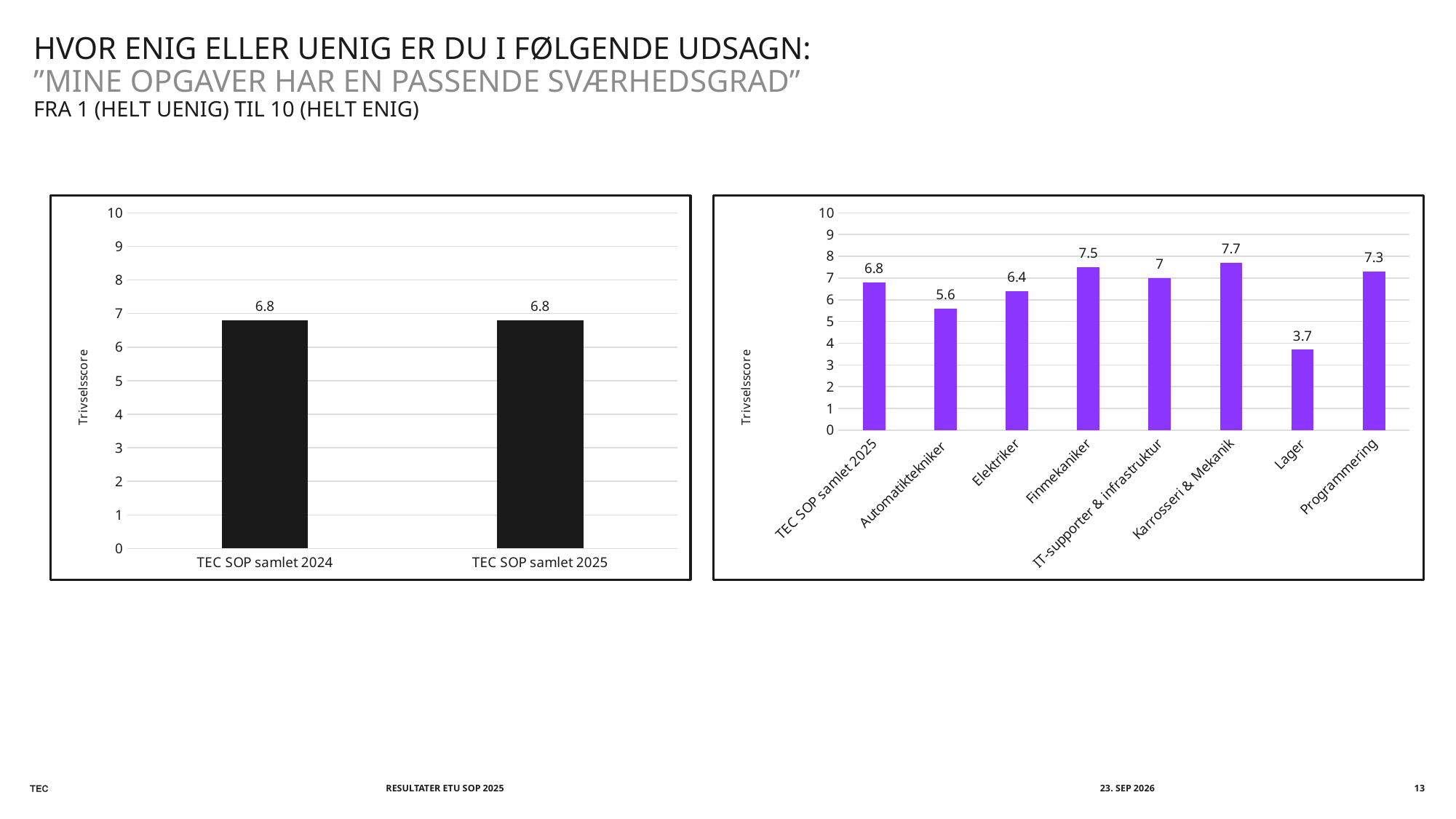
In the right chart, which is larger, Programmering or Elektriker? Programmering In the right chart, what is the value for Lager? 3.7 In the right chart, what is the value for Karrosseri & Mekanik? 7.7 What kind of chart is the left chart? bar chart In the left chart, what is the value for TEC SOP samlet 2024? 6.8 In the right chart, which category has the highest value? Karrosseri & Mekanik In the right chart, what is the difference between Finmekaniker and Automatiktekniker? 1.9 What is the y-axis label on the right chart? Trivselsscore In the left chart, what is the value for TEC SOP samlet 2025? 6.8 In the right chart, how many categories are plotted? 8 In the left chart, how many bars are plotted? 2 In the right chart, which category has the lowest value? Lager